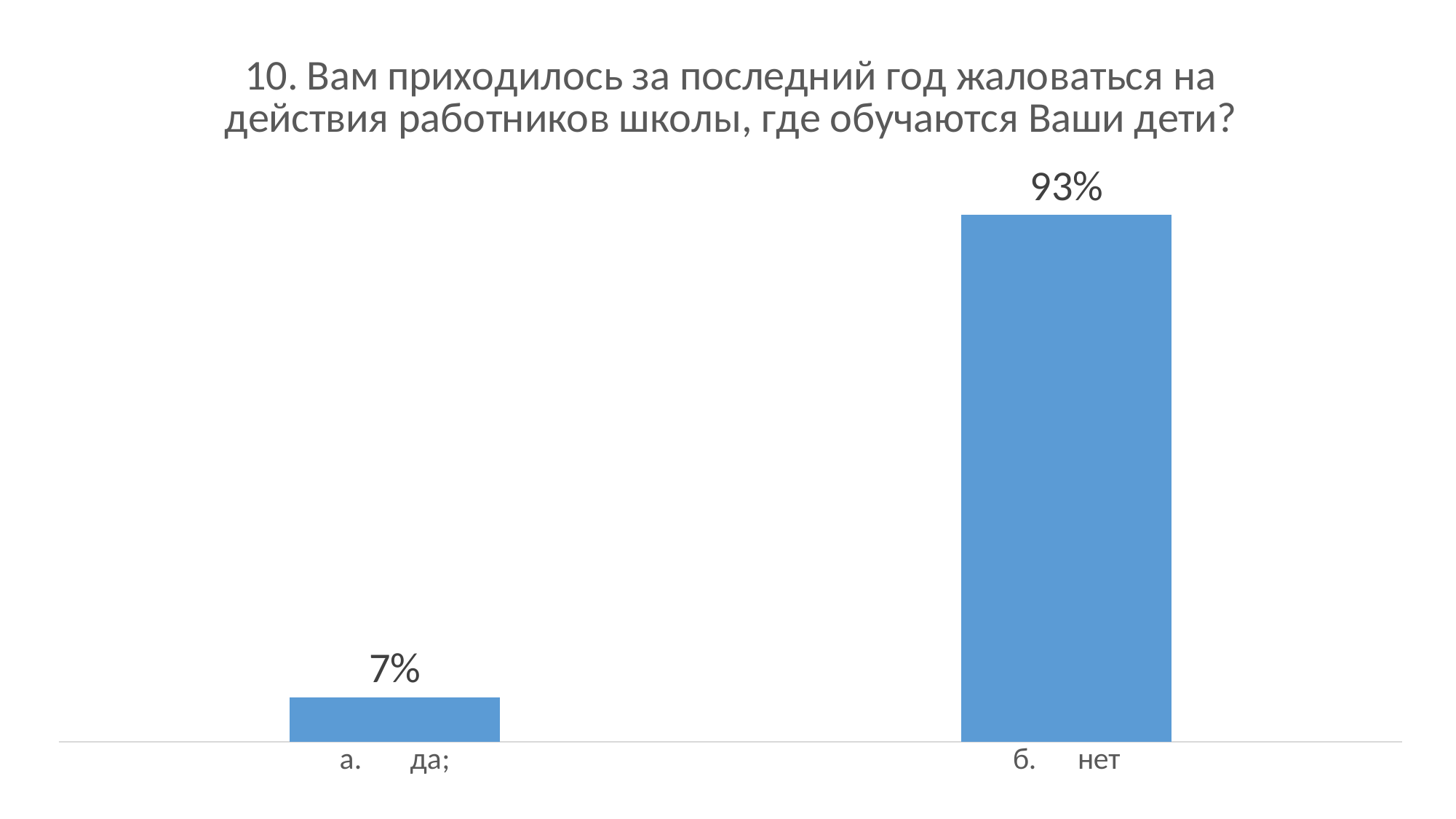
What kind of chart is shown on the slide? bar chart Which category has the lowest value? а. да; What question number is given at the start of the chart title? 10 Which category has the highest value? б. нет What is the value for "б. нет"? 93% What is the difference between the values for "б. нет" and "а. да;"? 86% How many categories are shown in the chart? 2 Which is larger, the value for "а. да;" or the value for "б. нет"? б. нет What is the total of the two values shown in the chart? 100% What is the value for "а. да;"? 7% What colour are the bars in the chart? blue